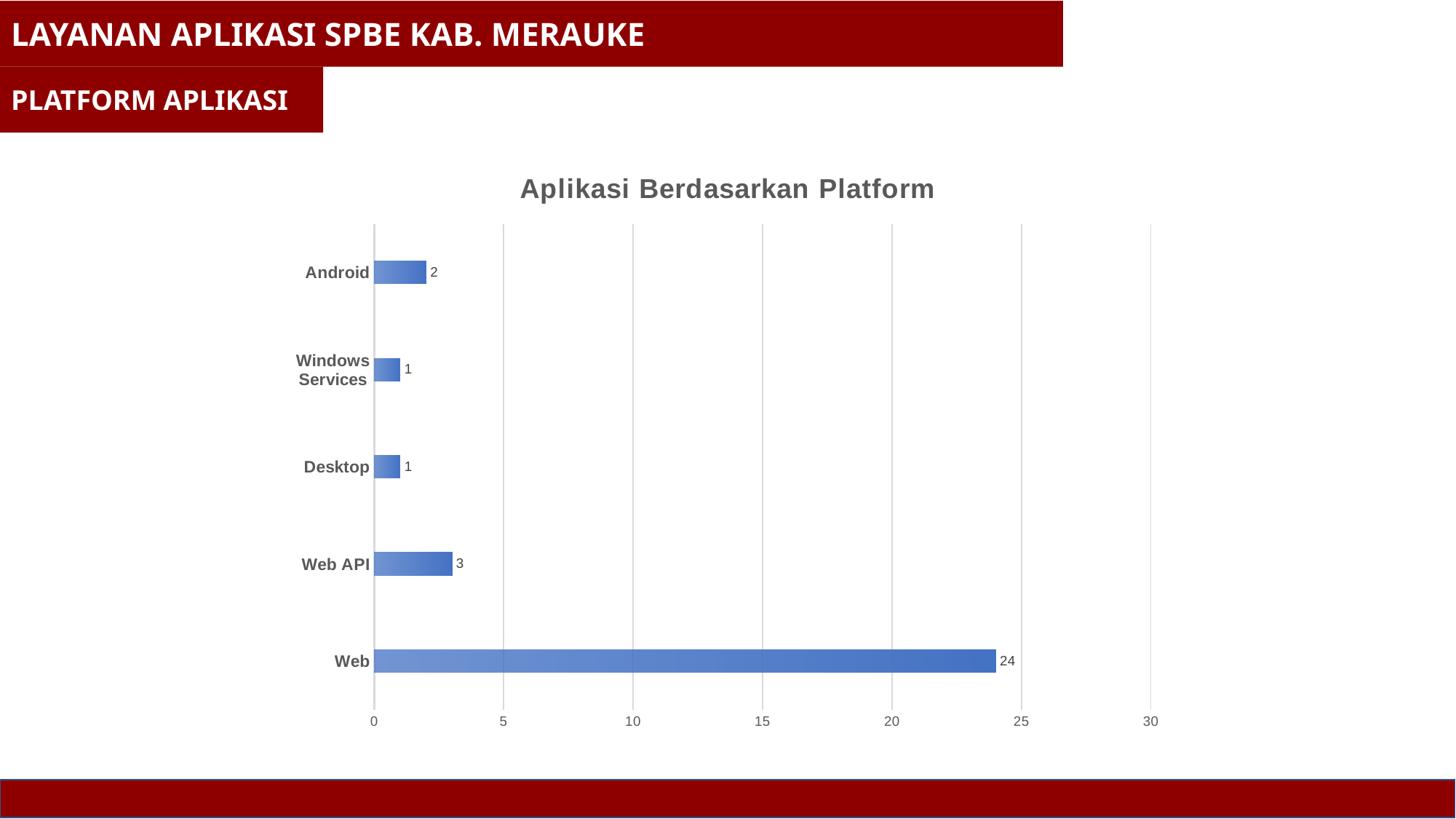
How many platform categories are shown in the chart? 5 Which is larger, the value for Android or the value for Desktop? Android What is the value for Web API? 3 Which platform has the highest value? Web What is the value for Web in the chart? 24 What is the title of the chart? Aplikasi Berdasarkan Platform What is the value for Windows Services? 1 What is the difference between the values for Web and Web API? 21 What kind of chart is shown on the slide? bar chart Is the value for Web greater or less than 20? greater What is the value for Android? 2 What is the total of all the values shown in the chart? 31